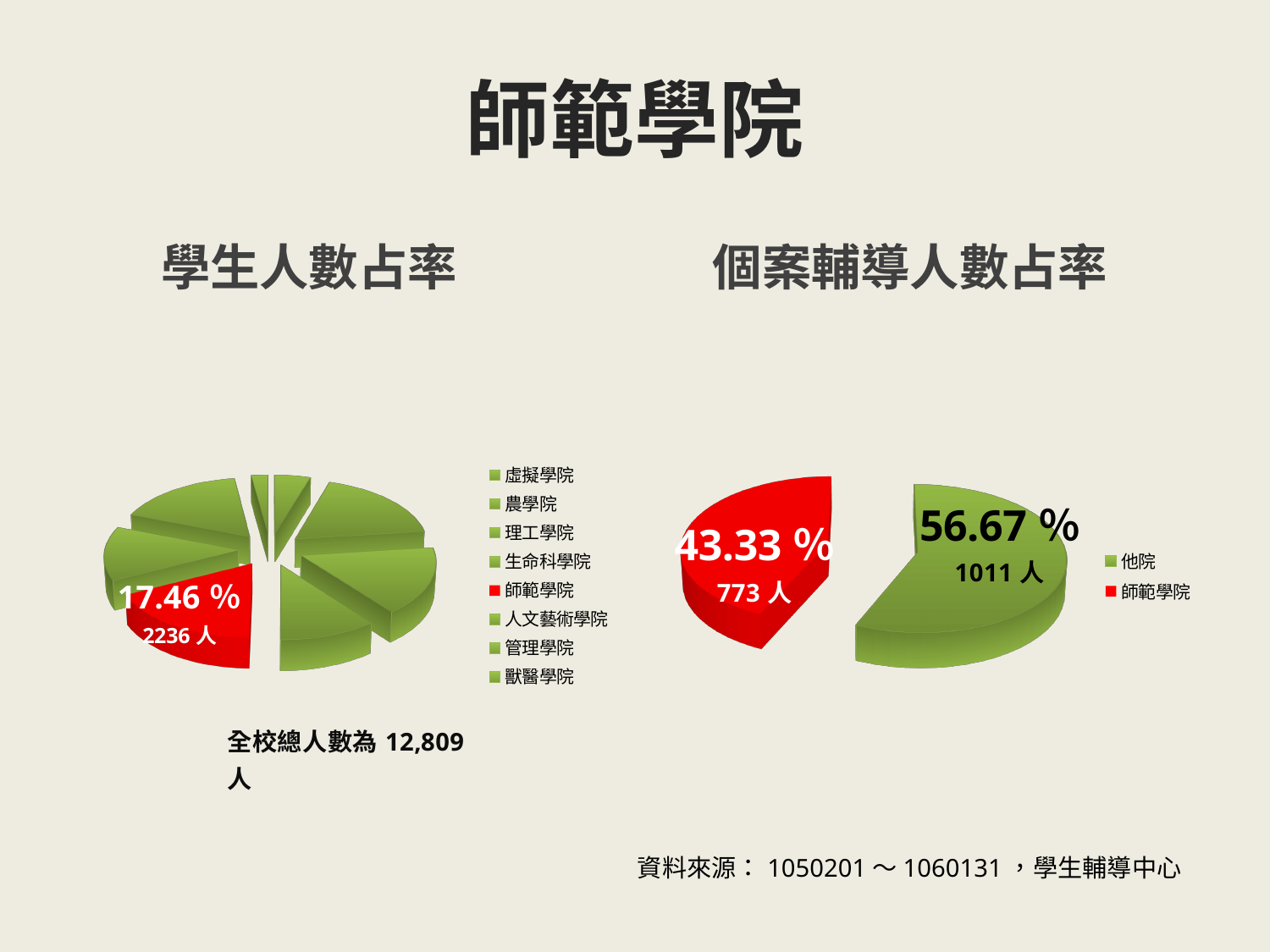
In the 個案輔導人數占率 chart, what percentage is shown for 他院? 56.67 % In the 個案輔導人數占率 chart, what is the difference in people between 他院 and 師範學院? 238 人 In the 個案輔導人數占率 chart, what percentage is shown for 師範學院? 43.33 % In the 個案輔導人數占率 chart, which slice is larger, 他院 or 師範學院? 他院 In the 個案輔導人數占率 chart, how many people does the 他院 slice represent? 1011 人 In the 個案輔導人數占率 chart, how many people does the 師範學院 slice represent? 773 人 How many entries does the legend of the 個案輔導人數占率 chart list? 2 What kind of chart is the 學生人數占率 chart? pie chart In the 學生人數占率 chart, what percentage is shown for 師範學院? 17.46 % What kind of chart is the 個案輔導人數占率 chart? pie chart How many entries does the legend of the 學生人數占率 chart list? 8 In the 學生人數占率 chart, how many people does the 師範學院 slice represent? 2236 人